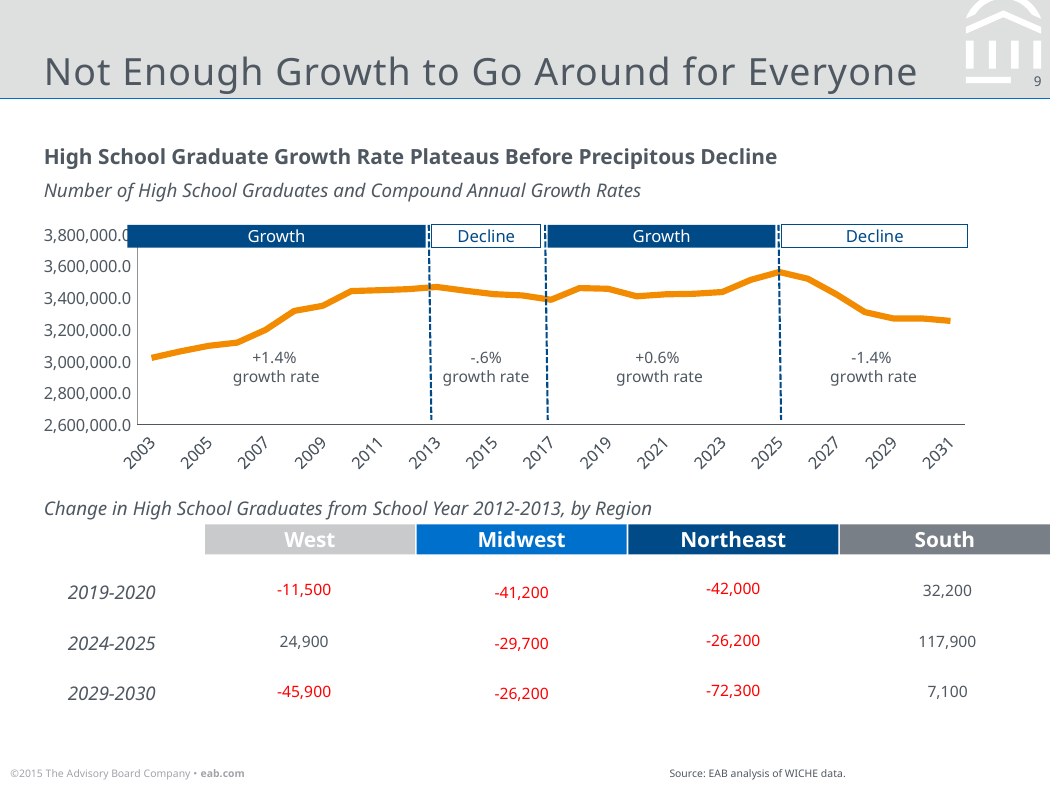
Does the number of high school graduates rise or fall from 2025 to 2031? fall What is the growth rate shown for the first 'Decline' period (2013 to 2017)? -.6% Is the number of high school graduates in 2025 greater or less than 3,400,000? greater How many labeled growth/decline periods are marked across the top of the chart? 4 What is the growth rate shown for the final 'Decline' period (2025 to 2031)? -1.4% Is the number of high school graduates in 2031 greater or less than 3,400,000? less Which year has the highest number of high school graduates on the chart? 2025 Is the number of high school graduates in 2003 greater or less than 3,200,000? less What is the growth rate shown for the second 'Growth' period (2017 to 2025)? +0.6% What is the growth rate shown for the first 'Growth' period (2003 to 2013)? +1.4% What kind of chart is shown on the slide? line chart Which year has the lowest number of high school graduates on the chart? 2003